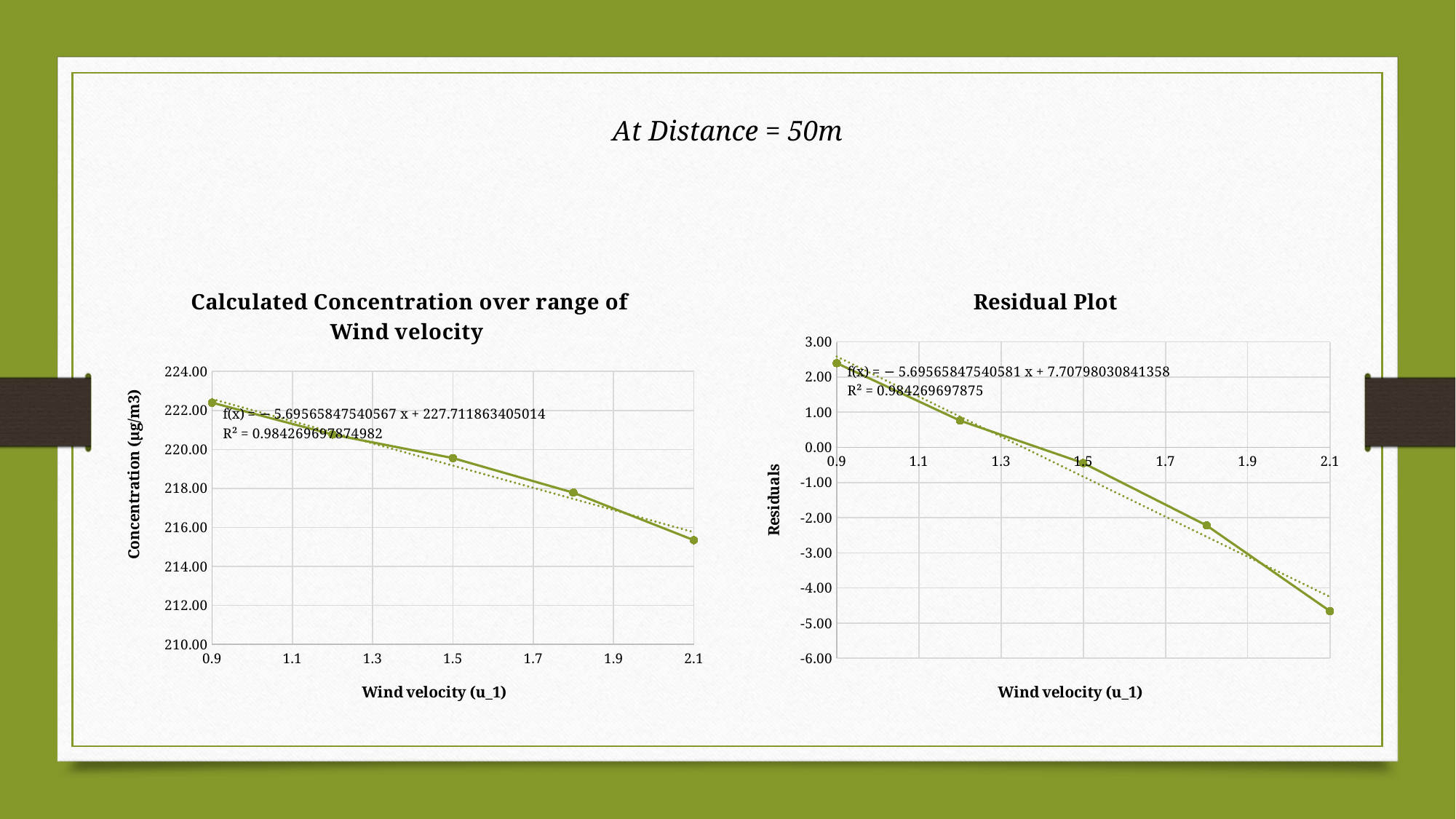
How many data points are plotted in the 'Calculated Concentration over range of Wind velocity' chart? 5 How many data points are plotted in the 'Residual Plot' chart? 5 In the 'Residual Plot' chart, is the residual at wind velocity 2.1 greater or less than -4.00? less In the 'Calculated Concentration over range of Wind velocity' chart, is the concentration at wind velocity 1.5 greater or less than 220.00? less In the 'Calculated Concentration over range of Wind velocity' chart, do the values rise or fall as wind velocity increases? fall In the 'Calculated Concentration over range of Wind velocity' chart, is the concentration at wind velocity 2.1 greater or less than 216.00? less What kind of chart is the 'Calculated Concentration over range of Wind velocity' chart? line chart In the 'Residual Plot' chart, which wind velocity has the lowest residual? 2.1 What is the y-axis title of the 'Calculated Concentration over range of Wind velocity' chart? Concentration (µg/m3) In the 'Calculated Concentration over range of Wind velocity' chart, which wind velocity has the highest concentration? 0.9 In the 'Residual Plot' chart, do the residuals rise or fall as wind velocity increases? fall